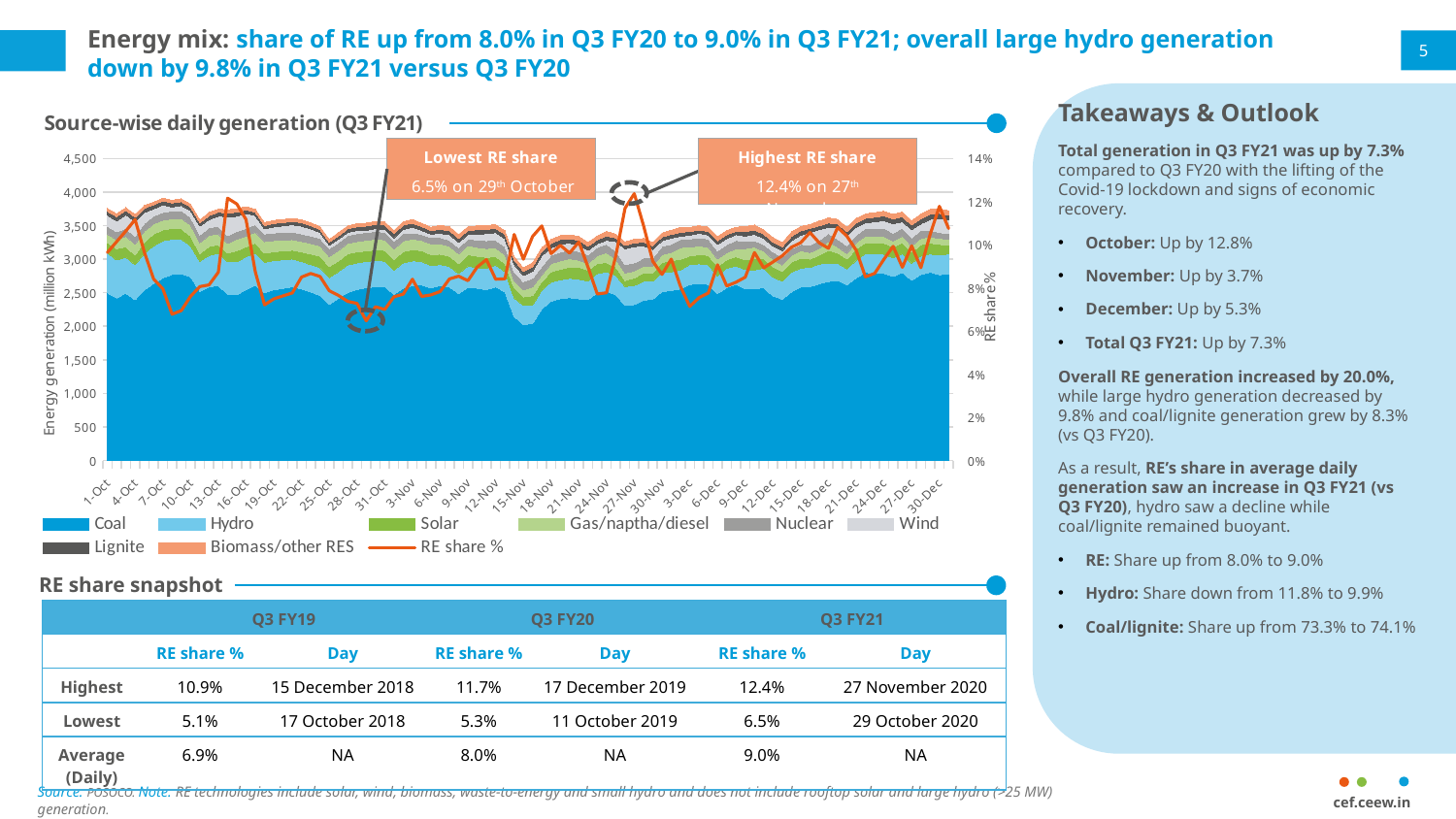
Which source accounts for the largest portion of daily generation in the chart? Coal Was the RE share higher on 27th November or on 29th October? 27th November What kind of chart is used to show source-wise daily generation? Stacked area chart with a line for RE share % What is the title of the chart on the slide? Source-wise daily generation (Q3 FY21) Is the RE share on 29th October greater or less than 8%? less What was the lowest RE share in Q3 FY21 according to the chart annotation? 6.5% What is the difference between the highest and lowest RE share shown in the chart annotations? 5.9 percentage points What is the label of the left vertical axis of the chart? Energy generation (million kWh) On which date did the highest RE share occur in the chart? 27th November What was the highest RE share in Q3 FY21 according to the chart annotation? 12.4% On which date did the lowest RE share occur in the chart? 29th October How many series does the chart legend list? 9